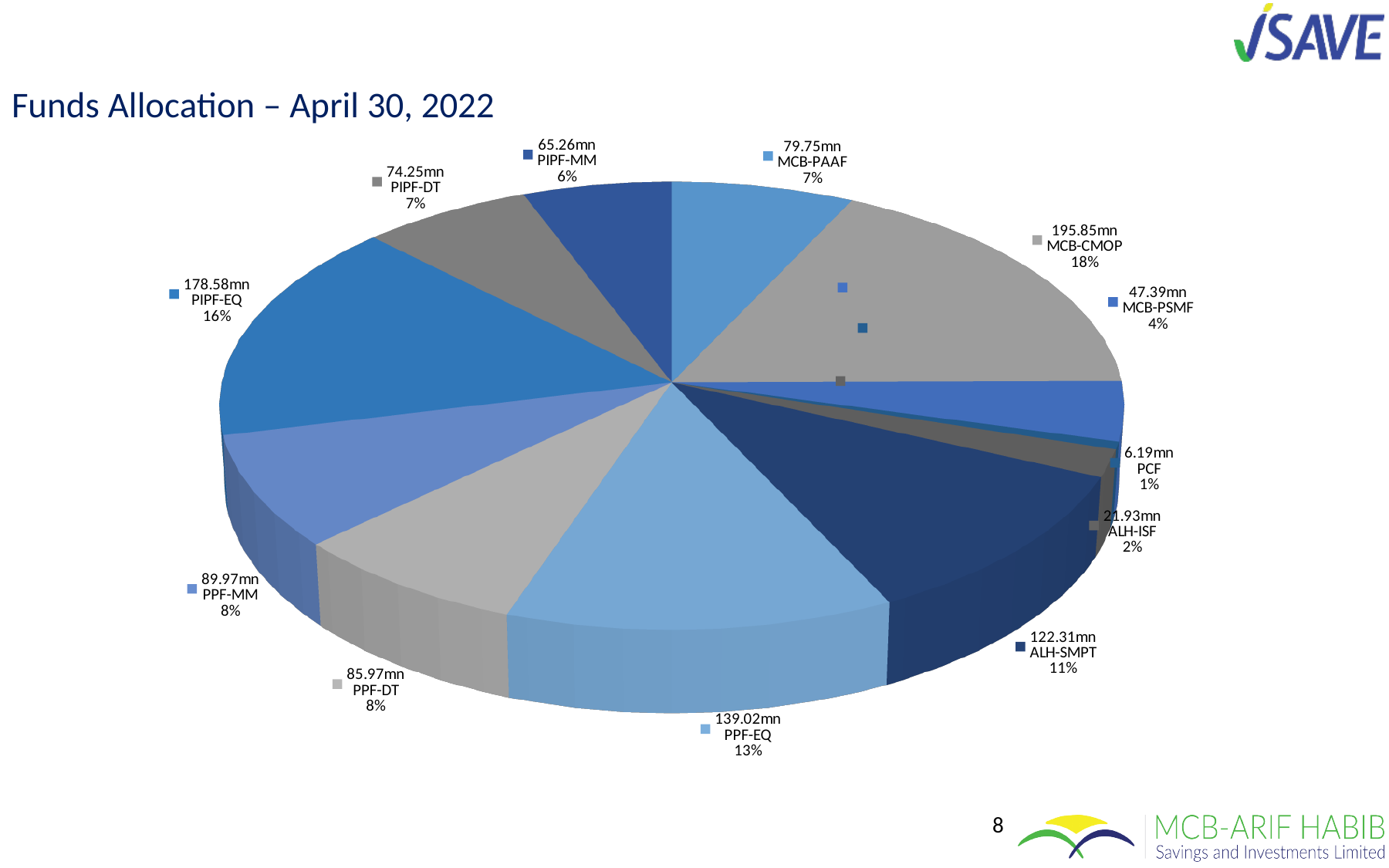
What is the difference between the values for PPF-EQ and ALH-SMPT? 16.71mn What is the value for PIPF-EQ? 178.58mn Which fund has the smallest allocation? PCF What is the value for MCB-CMOP? 195.85mn Which fund has the largest allocation? MCB-CMOP What share of the pie does PPF-EQ represent? 13% Which is larger, the value for MCB-PSMF or the value for ALH-ISF? MCB-PSMF What share of the pie does ALH-SMPT represent? 11% What is the title of the chart? Funds Allocation – April 30, 2022 What kind of chart is shown on the slide? Pie chart What is the difference between the values for MCB-CMOP and PIPF-EQ? 17.27mn Which is larger, the value for MCB-PAAF or the value for PIPF-MM? MCB-PAAF